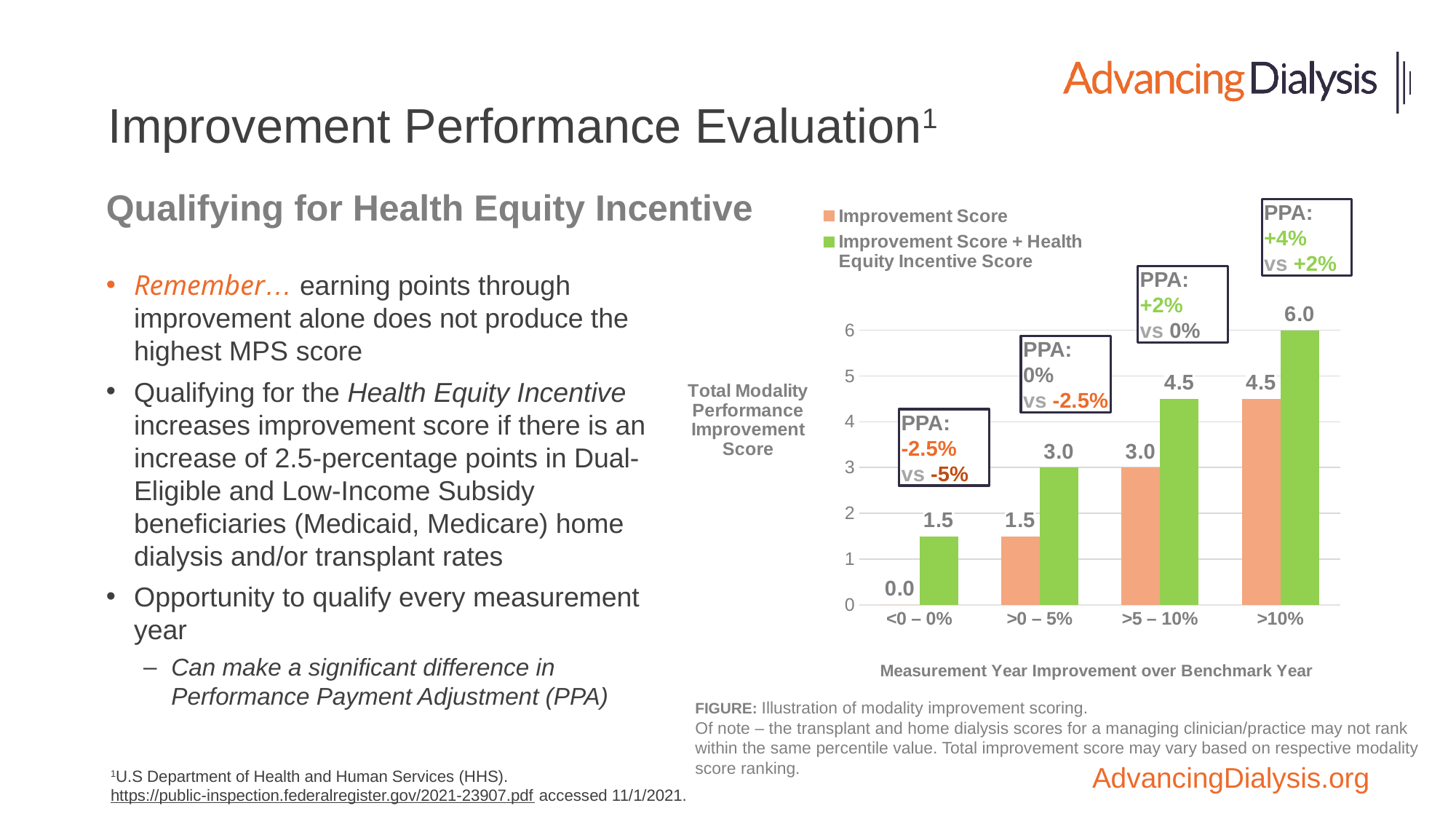
What is the Improvement Score for the <0 – 0% category? 0.0 What type of chart is shown on the slide? bar chart Which category has the highest Improvement Score + Health Equity Incentive Score? >10% How many categories are shown on the x axis of the chart? 4 Do the Improvement Score values rise or fall from left to right along the x axis? rise Which is larger for the >10% category: the Improvement Score or the Improvement Score + Health Equity Incentive Score? Improvement Score + Health Equity Incentive Score How many series does the chart legend list? 2 What is the Improvement Score for the >0 – 5% category? 1.5 Which category has the lowest Improvement Score? <0 – 0% What is the Improvement Score + Health Equity Incentive Score for the >10% category? 6.0 What is the difference between the Improvement Score + Health Equity Incentive Score and the Improvement Score for the >5 – 10% category? 1.5 What is the Improvement Score + Health Equity Incentive Score for the >5 – 10% category? 4.5